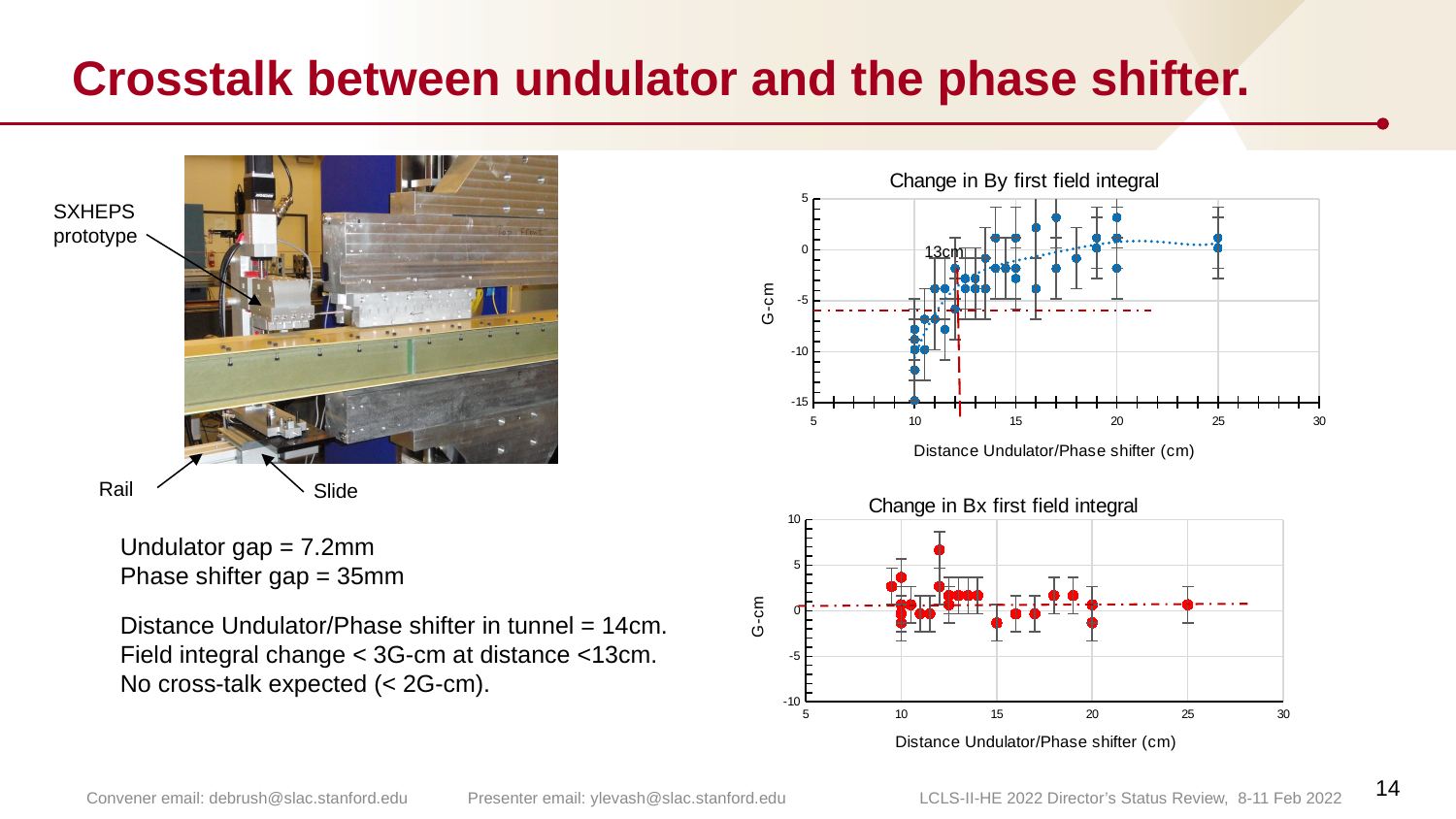
What kind of chart is the 'Change in By first field integral' chart? scatter chart What is the minimum value shown on the y-axis of the 'Change in By first field integral' chart? -15 In the 'Change in Bx first field integral' chart, is the highest plotted point near 12 cm greater or less than 5 G-cm? greater In the 'Change in By first field integral' chart, is the lowest plotted point at a distance of 10 cm greater or less than -10 G-cm? less What is the title of the upper chart on the right side of the slide? Change in By first field integral In the 'Change in By first field integral' chart, is the value at a distance of 25 cm greater or less than -5 G-cm? greater What is the maximum value shown on the y-axis of the 'Change in Bx first field integral' chart? 10 In the 'Change in By first field integral' chart, do the plotted values generally rise or fall as the distance increases from 10 cm to 25 cm? rise What is the x-axis label of the 'Change in Bx first field integral' chart? Distance Undulator/Phase shifter (cm) How many charts are shown on the slide? 2 What is the title of the lower chart on the right side of the slide? Change in Bx first field integral